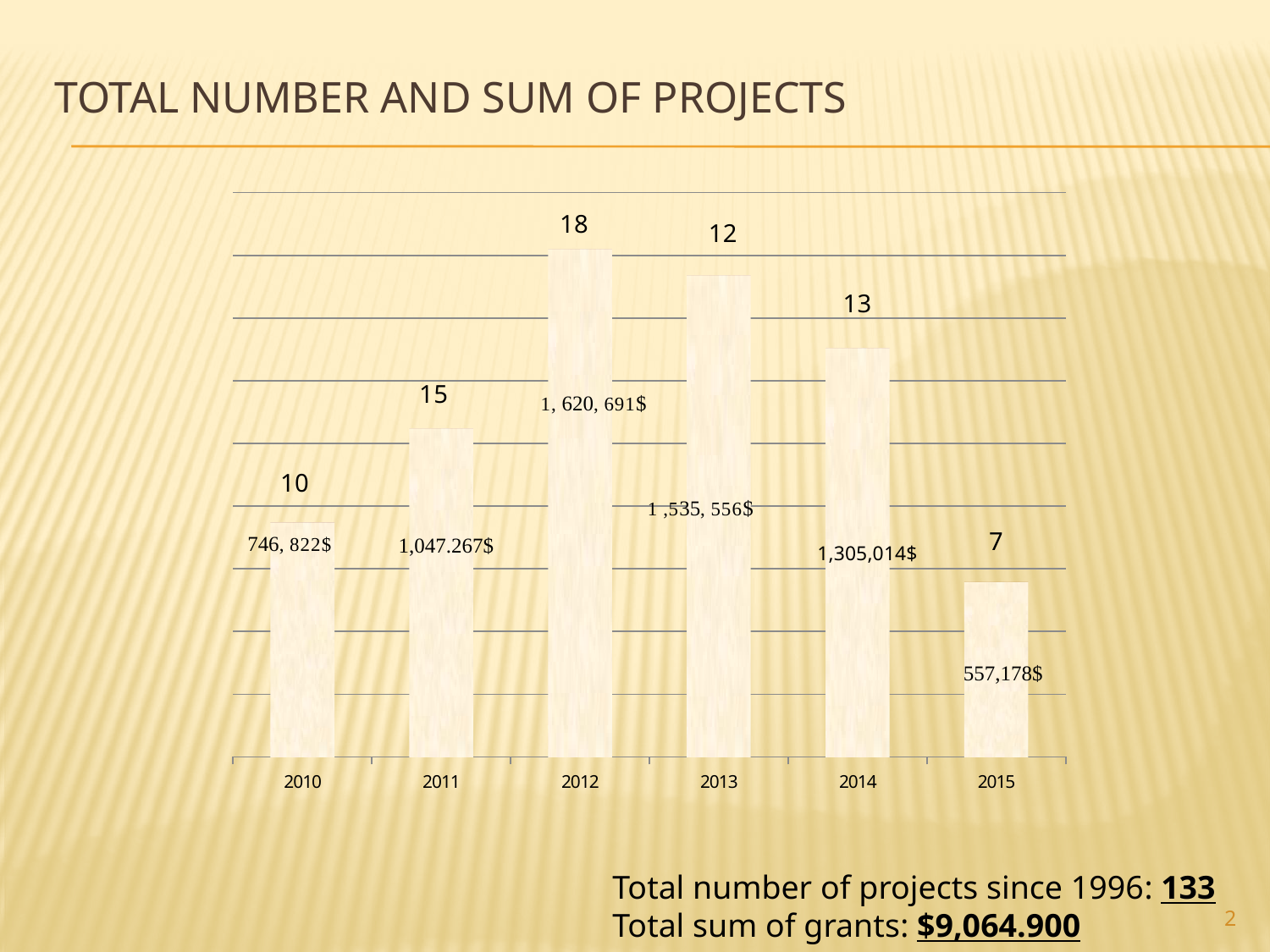
How many years are shown on the x axis of the chart? 6 What is the title of the slide containing the chart? TOTAL NUMBER AND SUM OF PROJECTS Which year has the lowest number of projects? 2015 Which year has more projects, 2011 or 2010? 2011 What is the number of projects shown for 2015? 7 Which year has the highest number of projects? 2012 What type of chart is shown on the slide? bar chart What sum is printed on the chart for 2014? 1,305,014$ What is the difference between the number of projects in 2012 and in 2015? 11 What is the number of projects shown for 2012? 18 What is the number of projects shown for 2010? 10 What sum is printed on the chart for 2015? 557,178$